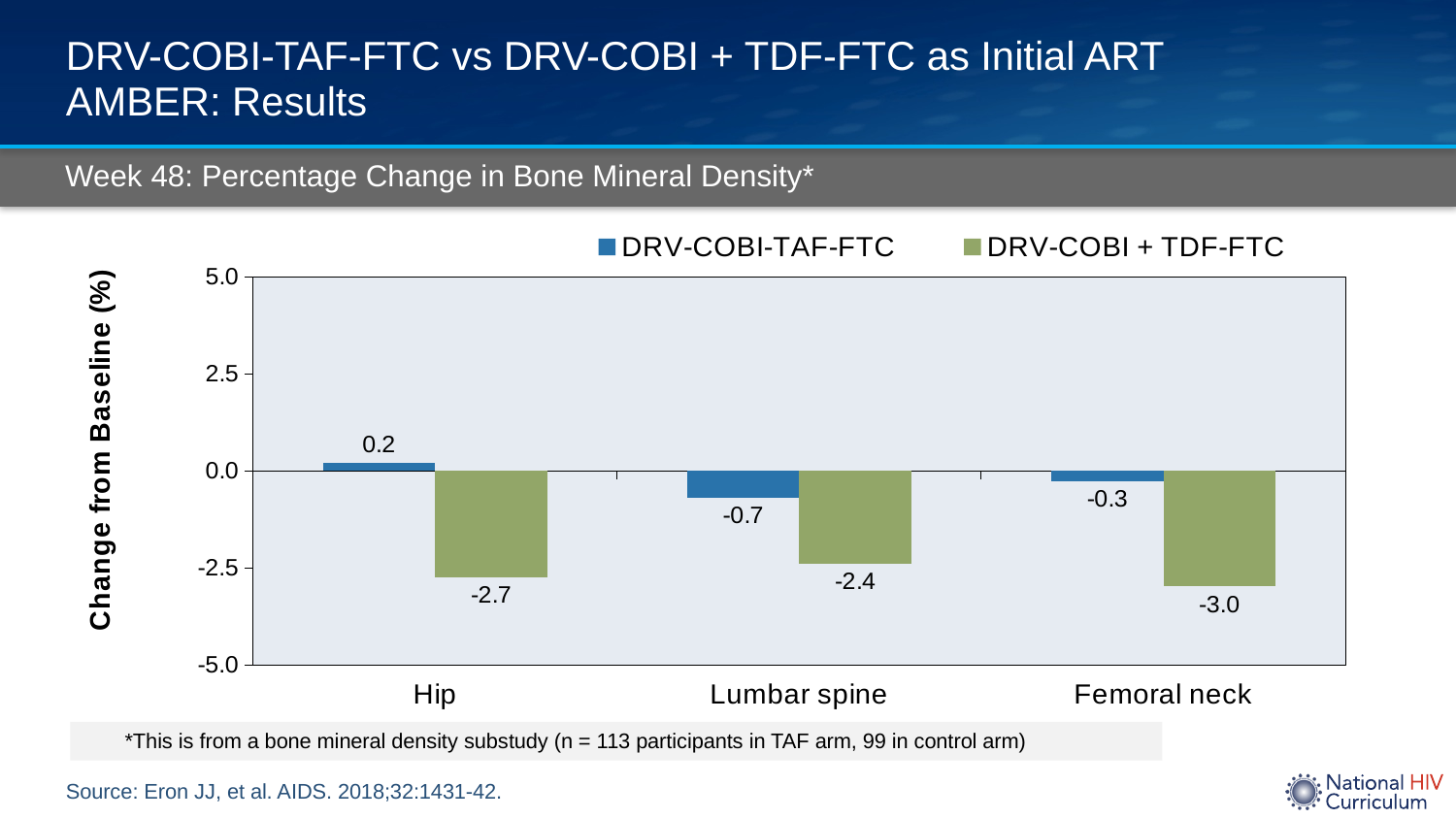
What kind of chart is shown on the slide? Bar chart How many body sites are shown on the x axis? 3 Which site shows the highest value for DRV-COBI-TAF-FTC? Hip What is the percentage change from baseline at the lumbar spine for DRV-COBI + TDF-FTC? -2.4 How many series does the legend list? 2 What is the percentage change from baseline at the femoral neck for DRV-COBI-TAF-FTC? -0.3 What is the percentage change from baseline at the hip for DRV-COBI + TDF-FTC? -2.7 Which site shows the lowest value for DRV-COBI + TDF-FTC? Femoral neck What is the percentage change from baseline in bone mineral density at the hip for DRV-COBI-TAF-FTC? 0.2 What is the difference between the DRV-COBI-TAF-FTC and DRV-COBI + TDF-FTC values at the lumbar spine? 1.7 What is the label of the y axis? Change from Baseline (%) Which arm has the larger (less negative) change at the femoral neck, DRV-COBI-TAF-FTC or DRV-COBI + TDF-FTC? DRV-COBI-TAF-FTC